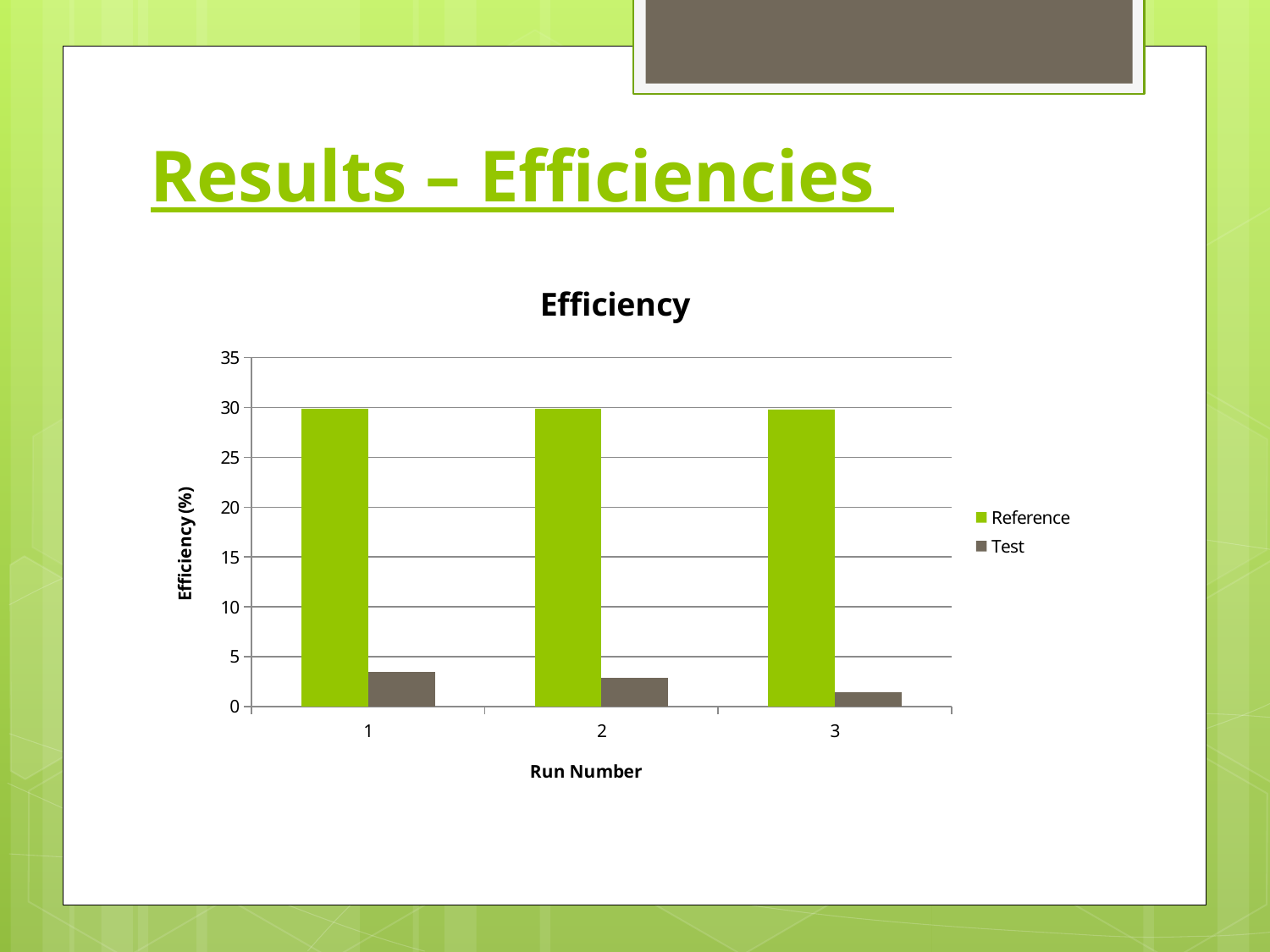
Which run number has the highest Test value? 1 How many run numbers are shown on the x axis of the Efficiency chart? 3 What is the title of the chart? Efficiency What is the label on the y axis of the chart? Efficiency (%) What kind of chart is shown on the slide? bar chart Is the Test value for run 1 greater or less than 5? less Is the Reference value for run 2 greater or less than 25? greater How many series does the legend of the Efficiency chart list? 2 Which series has the larger value for run 1, Reference or Test? Reference Is the Reference value for run 3 greater or less than 35? less Do the Test values rise or fall from run 1 to run 3? fall Which run number has the lowest Test value? 3